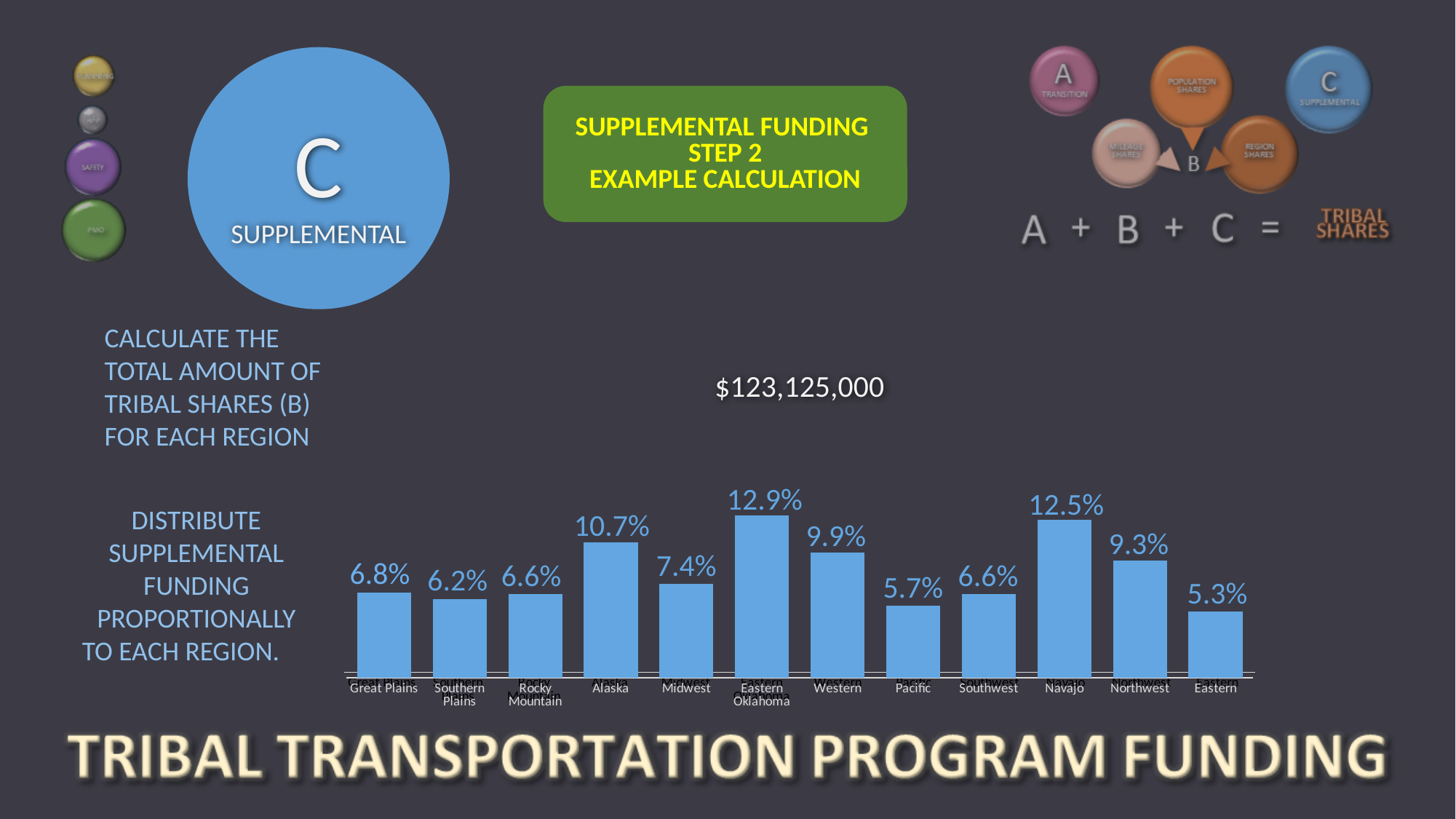
Which is larger, the value for Great Plains or the value for Southern Plains? Great Plains What kind of chart is shown on the slide? Bar chart Which region has the highest value in the chart? Eastern Oklahoma What is the value shown for Alaska? 10.7% What title is shown above the chart? $123,125,000 What is the difference between the values for Western and Northwest? 0.6% What is the value shown for Pacific? 5.7% Which is larger, the value for Midwest or the value for Rocky Mountain? Midwest Which region has the lowest value in the chart? Eastern What is the difference between the values for Eastern Oklahoma and Navajo? 0.4% What is the value shown for Navajo? 12.5% How many regions are shown in the chart? 12